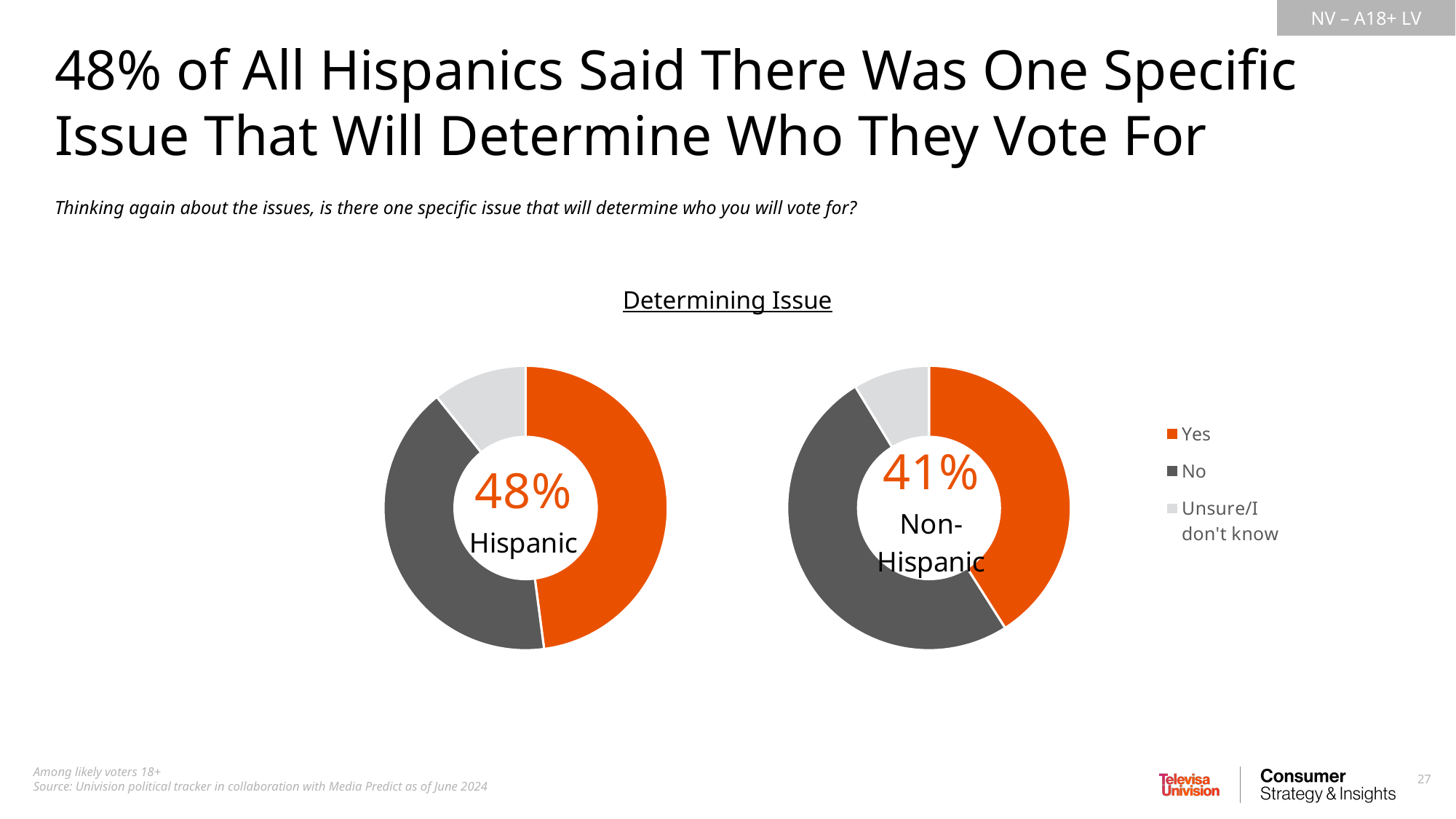
Which colour represents the Yes response in the donut charts? Orange What is the title shown above the two donut charts? Determining Issue In the Hispanic donut chart, what percentage said Yes? 48% In the Non-Hispanic donut chart, what percentage said Yes? 41% How many categories does the legend list for the Determining Issue charts? 3 Which group has the higher Yes share, Hispanic or Non-Hispanic? Hispanic In the Hispanic donut chart, which response is the smallest slice? Unsure/I don't know What kind of chart is used to show the Determining Issue data? Donut (pie) chart What is the difference in percentage points between the Hispanic Yes share and the Non-Hispanic Yes share? 7 percentage points In the Non-Hispanic donut chart, which response is the smallest slice? Unsure/I don't know How many slices does the Hispanic donut chart have? 3 In the Non-Hispanic donut chart, which response is the largest slice? No